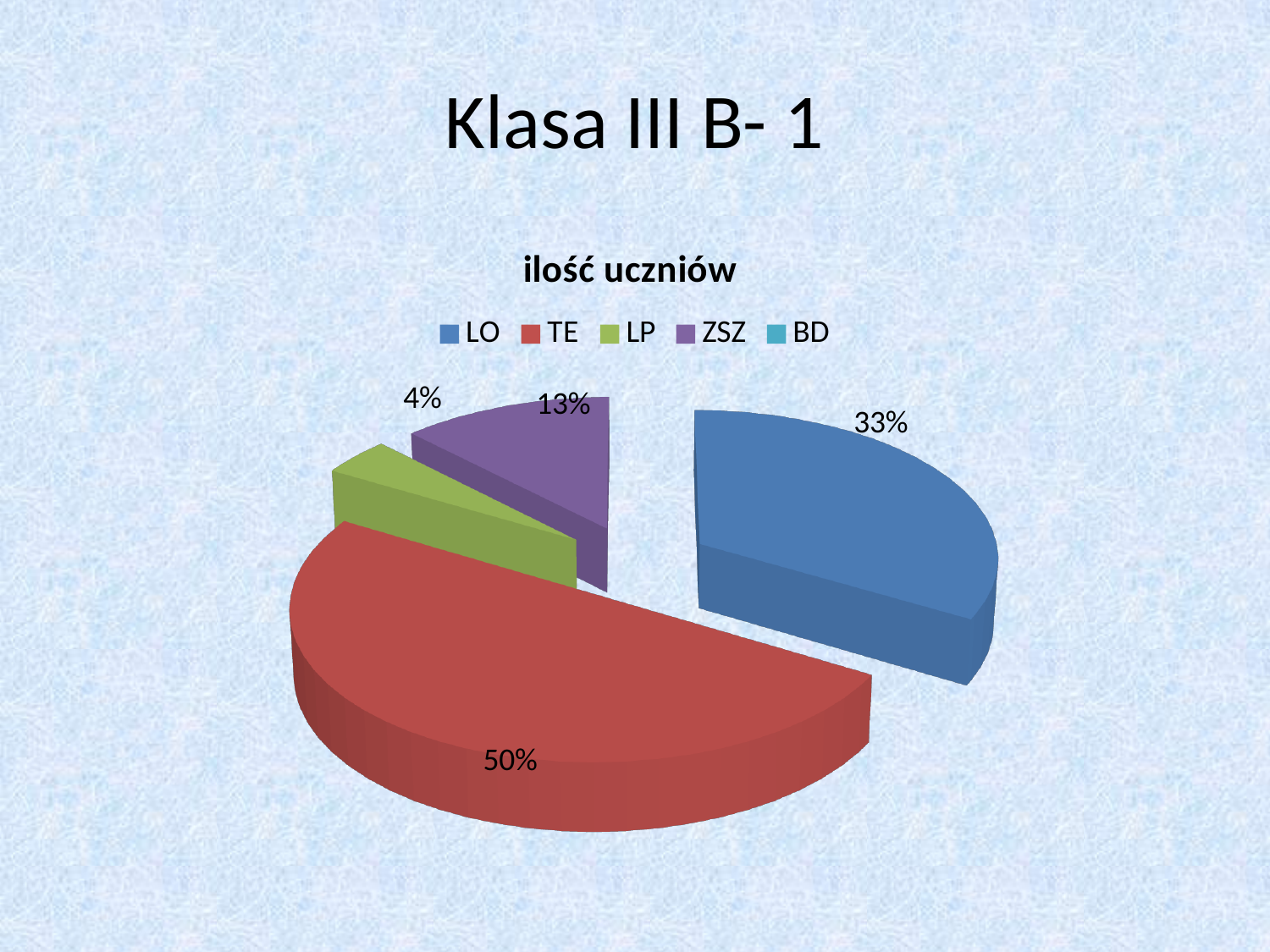
What is the difference in percentage points between the TE and LO slices? 17% Which category has the largest slice of the pie? TE What share of the pie does TE have? 50% What is the title of the chart? ilość uczniów What colour is the slice for LO? blue How many entries does the chart legend list? 5 What share of the pie does LP have? 4% What share of the pie does LO have? 33% What type of chart is shown on the slide? pie chart Which slice is larger, ZSZ or LP? ZSZ Which labelled slice of the pie is the smallest? LP